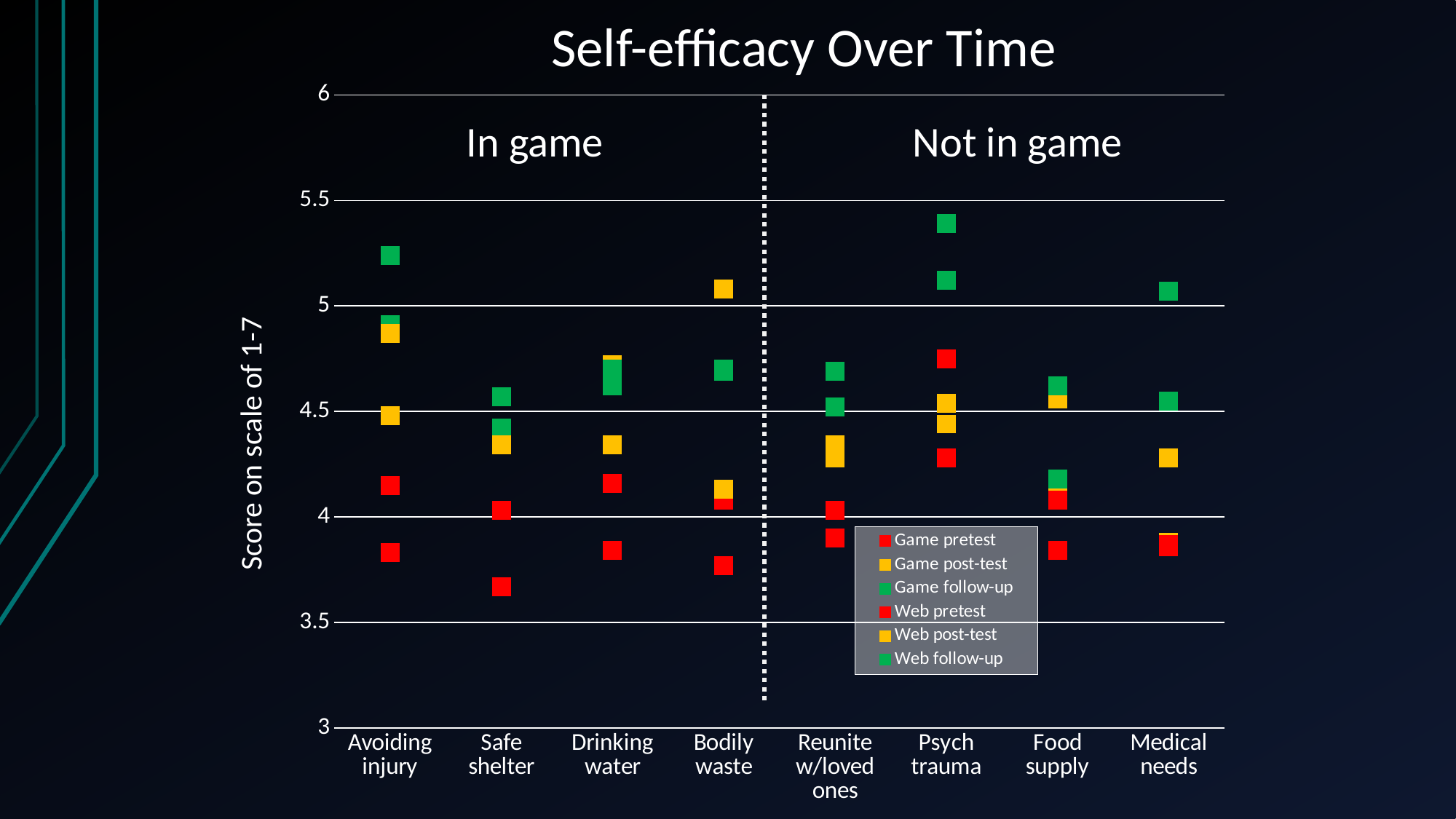
How many series does the legend list? 6 How many categories are shown along the x axis? 8 Which category has the highest plotted marker on the chart? Psych trauma Is the lowest marker for Safe shelter greater or less than 4? less Is the highest marker for Reunite w/loved ones greater or less than 5? less Which category has the lowest plotted marker on the chart? Safe shelter What is the title of the chart? Self-efficacy Over Time What is the label of the y axis? Score on scale of 1-7 Is the highest marker for Psych trauma greater or less than 5? greater How many categories are in the 'In game' group? 4 What kind of chart is shown on the slide? Scatter chart